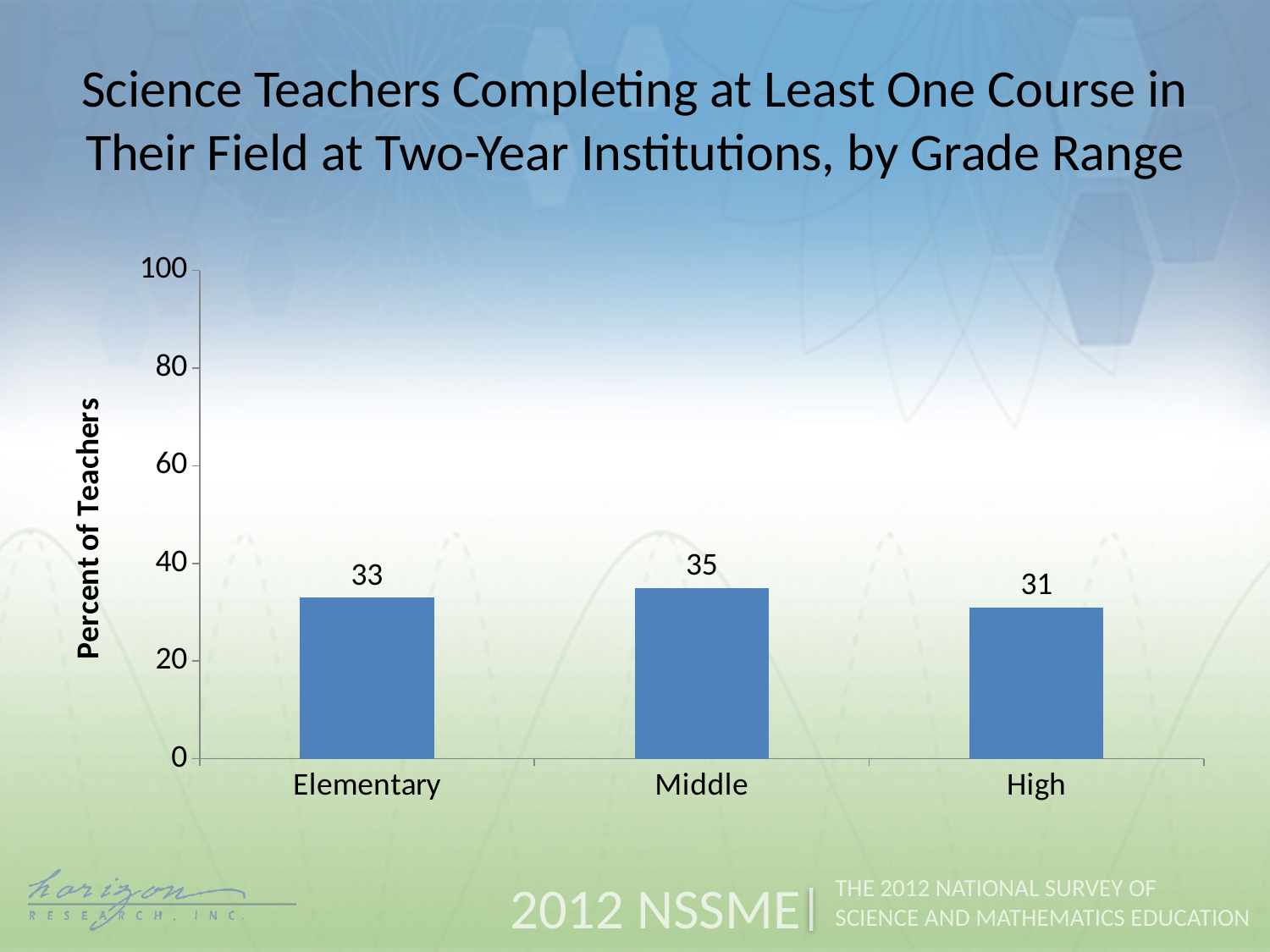
What is the label of the vertical axis? Percent of Teachers What is the value for Elementary? 33 What kind of chart is shown on the slide? bar chart Is the value for High greater or less than 40? less Which grade range has the lowest percent of teachers? High What is the value for High? 31 Which is larger, the value for Elementary or the value for Middle? Middle What is the difference between the values for Middle and High? 4 How many grade ranges are shown on the chart? 3 What is the value for Middle? 35 What is the difference between the values for Elementary and High? 2 Which grade range has the highest percent of teachers? Middle